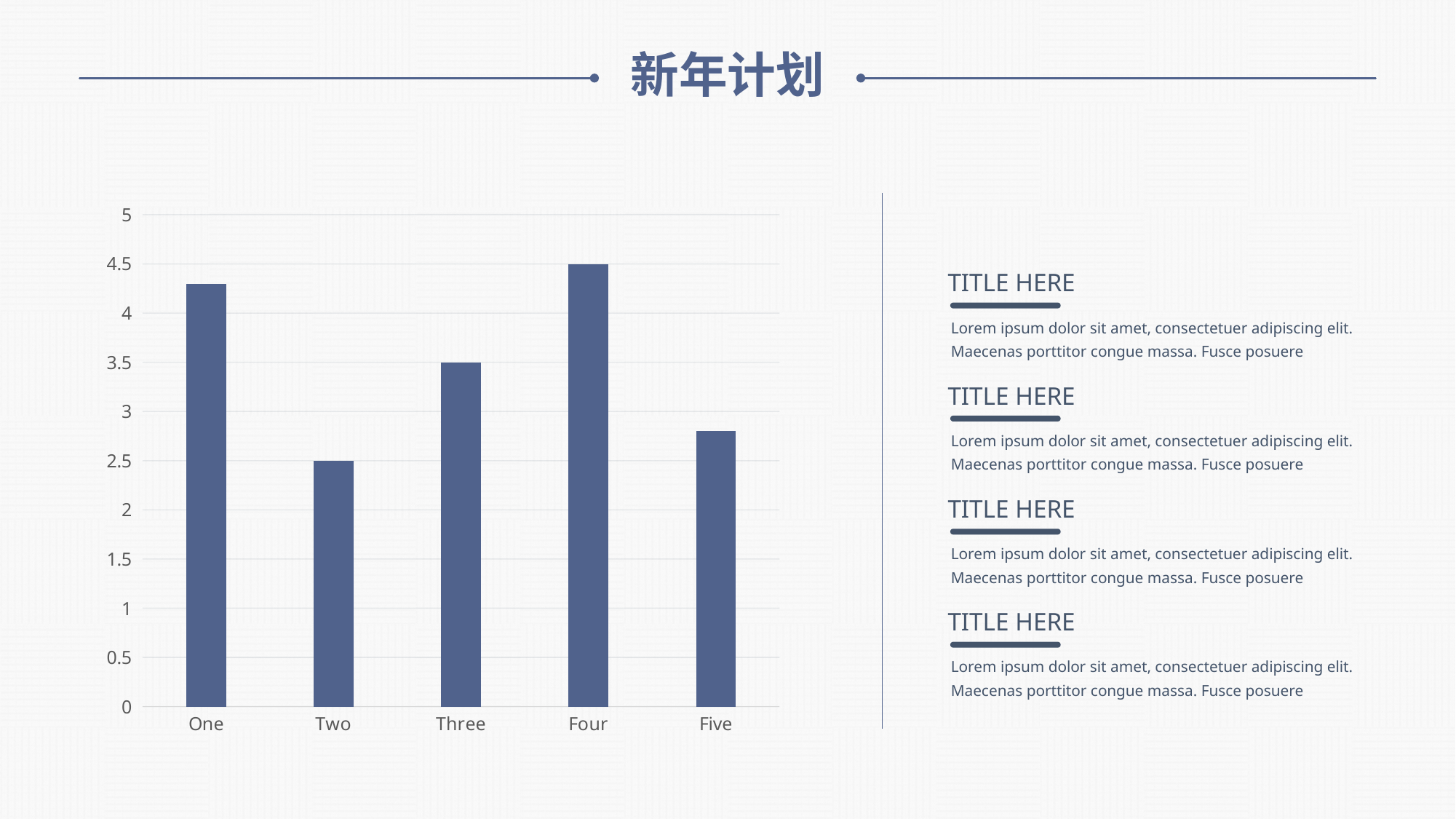
Which is larger, the value for One or the value for Three? One How many categories are shown on the x axis? 5 What is the value for Two? 2.5 Is the value for One greater or less than 4? greater What kind of chart is shown on the slide? bar chart Which category has the lowest value? Two What is the value for Three? 3.5 What is the difference between the values for Four and Three? 1 Is the value for Five greater or less than 3? less What is the value for Four? 4.5 What is the difference between the values for Four and Two? 2 Which category has the highest value? Four